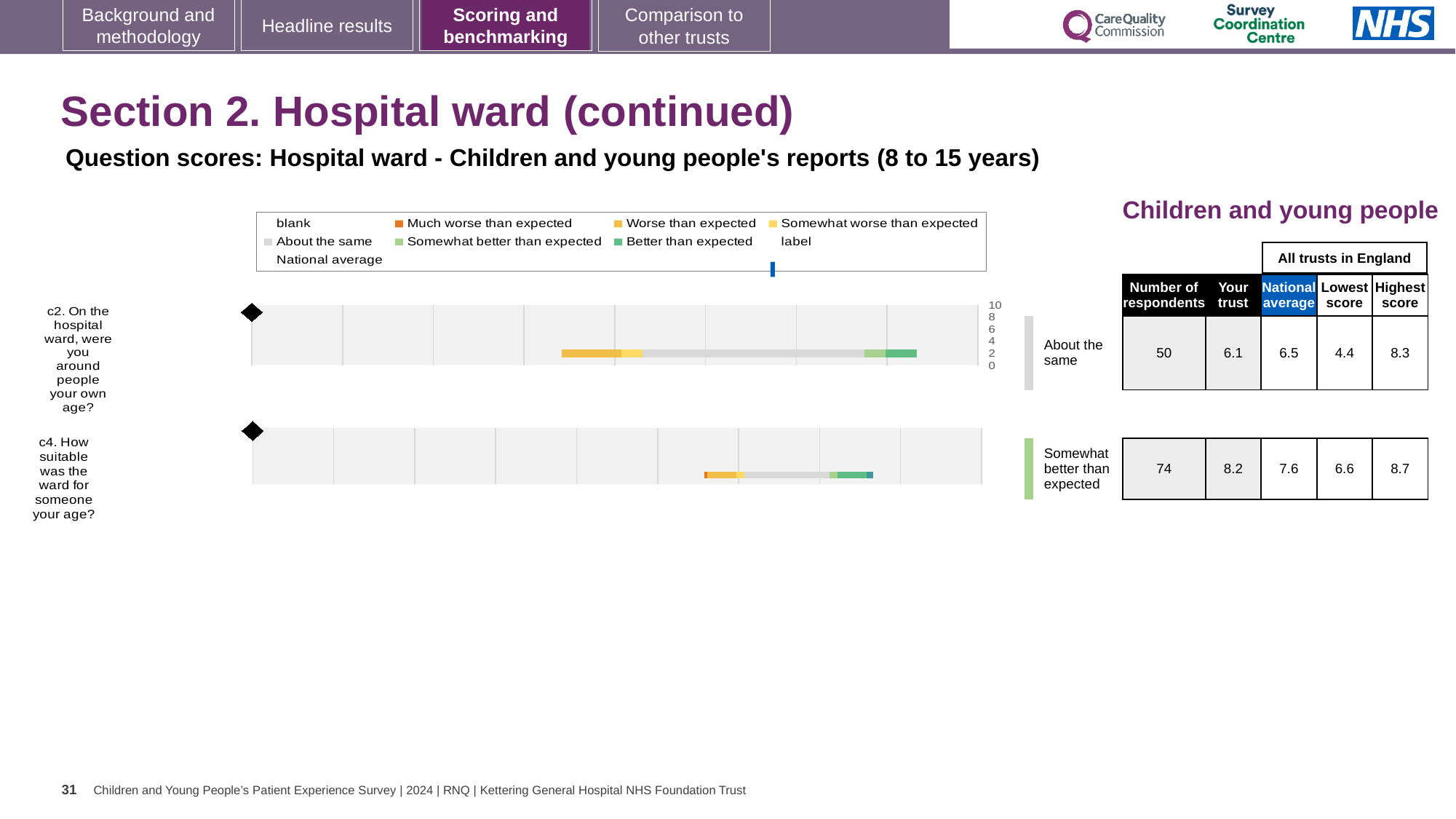
What is the lowest score across all trusts in England for question c4? 6.6 What is the national average score for question c2? 6.5 How many respondents answered question c4? 74 What benchmark category is shown for question c2? About the same Which question has the higher 'Your trust' score, c2 or c4? c4 By how much does the trust's score for c4 exceed the national average for c4? 0.6 What is the difference between the highest and lowest scores across all trusts for question c2? 3.9 What kind of chart is used to show the question scores? Bar chart How many survey questions are plotted in the chart? 2 What is the highest score across all trusts in England for question c2? 8.3 What is the 'Your trust' score for question c4 (How suitable was the ward for someone your age?)? 8.2 What is the 'Your trust' score for question c2 (On the hospital ward, were you around people your own age?)? 6.1